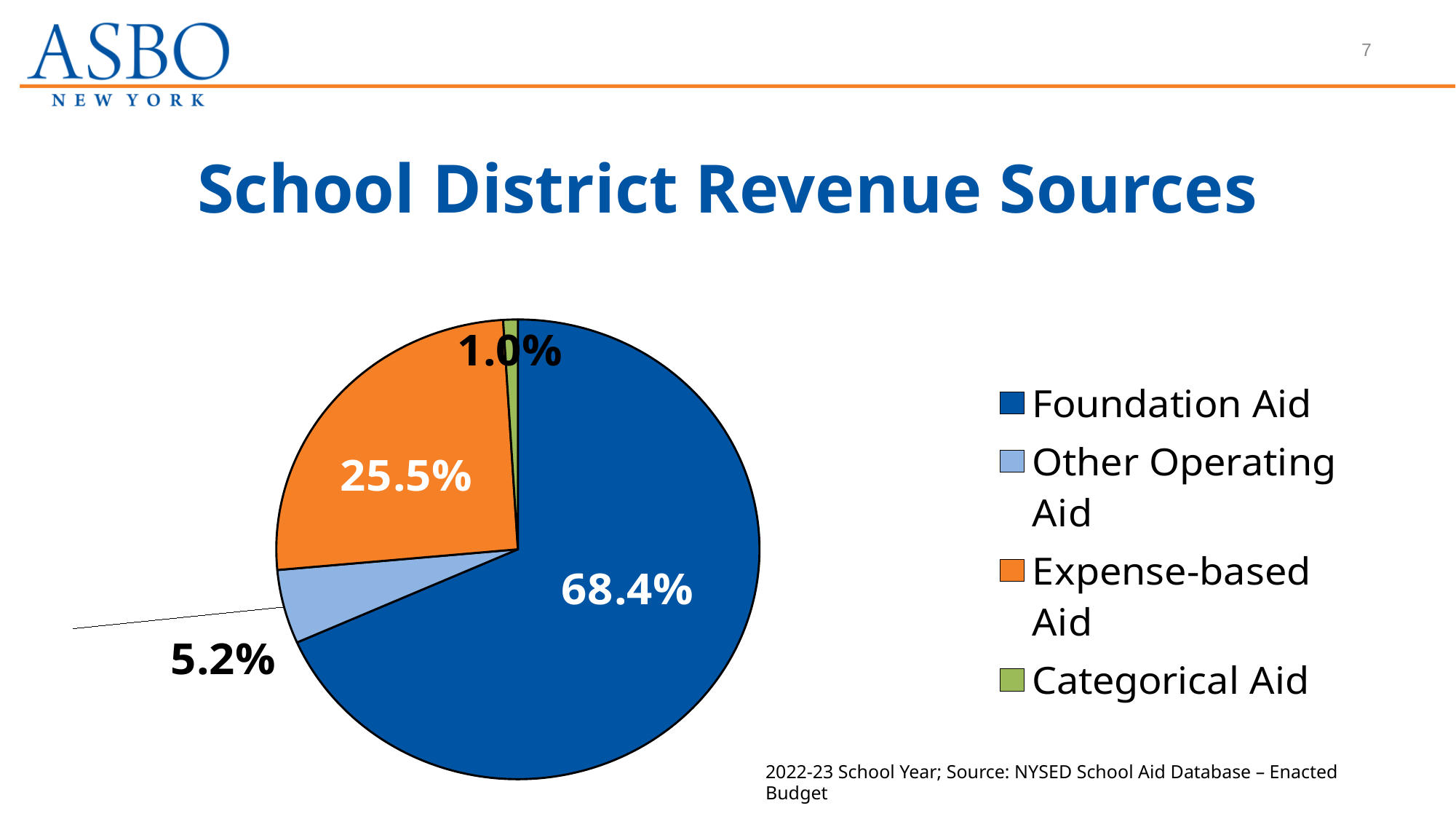
What share of school district revenue comes from Expense-based Aid? 25.5% What share of school district revenue comes from Other Operating Aid? 5.2% Which revenue source has the smallest share of the pie? Categorical Aid How many percentage points larger is the Foundation Aid share than the Expense-based Aid share? 42.9 percentage points What kind of chart is shown on the slide? pie chart What share of school district revenue comes from Foundation Aid? 68.4% Which revenue source has the largest share of the pie? Foundation Aid What share of school district revenue comes from Categorical Aid? 1.0% What colour is the Expense-based Aid slice? orange Which is larger, the share for Other Operating Aid or the share for Expense-based Aid? Expense-based Aid How many slices does the pie chart have? 4 How many entries does the legend list? 4